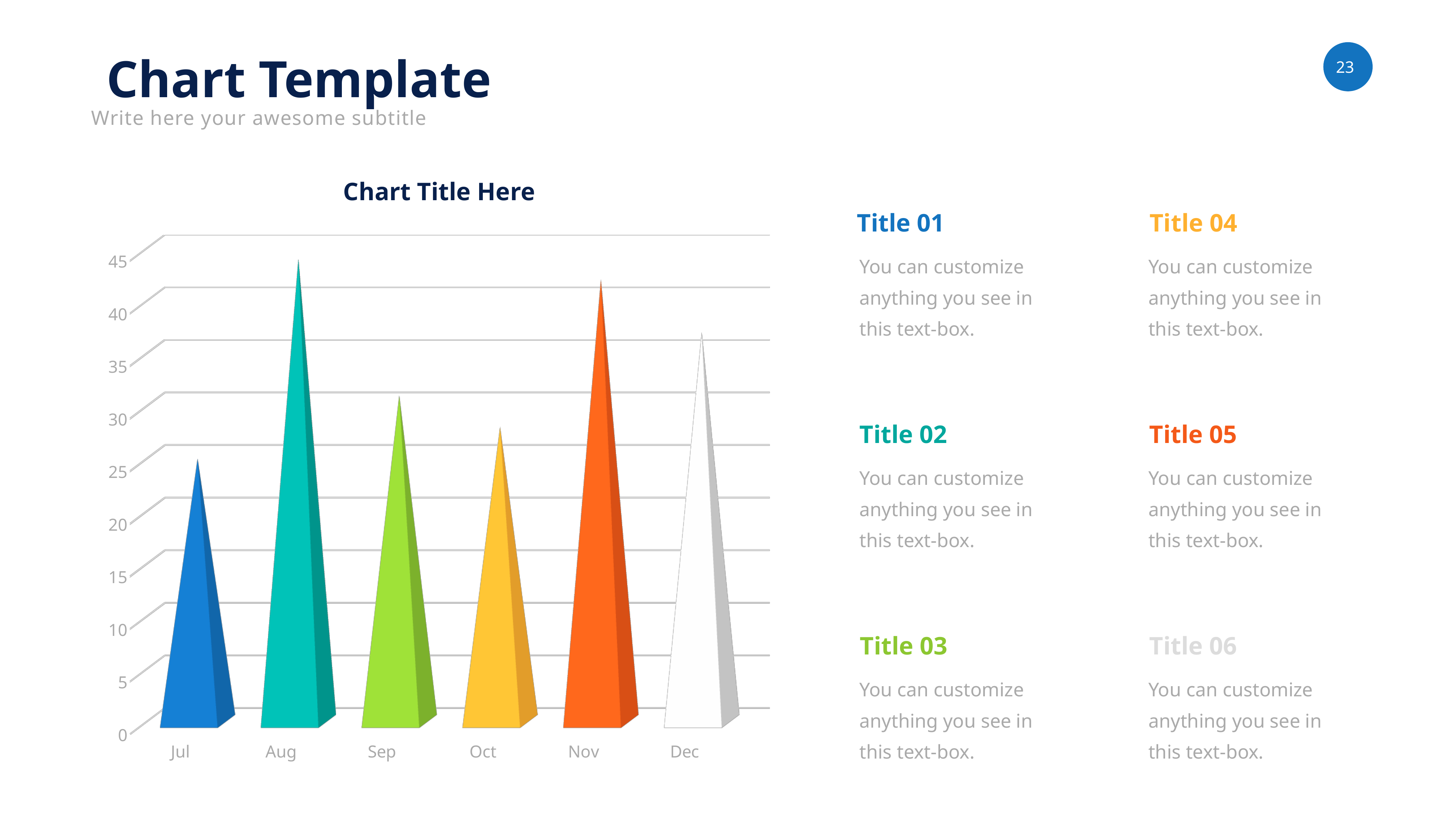
Which is larger, the value for Dec or the value for Jul? Dec What is the title of the chart? Chart Title Here What kind of chart is shown on the slide? bar chart How many categories (months) are plotted on the x axis of the chart? 6 What colour is the bar for Jul? blue Is the value for Nov greater or less than 40? greater Is the value for Jul greater or less than 30? less Is the value for Dec greater or less than 35? greater Which is larger, the value for Sep or the value for Oct? Sep Which month has the lowest value in the chart? Jul